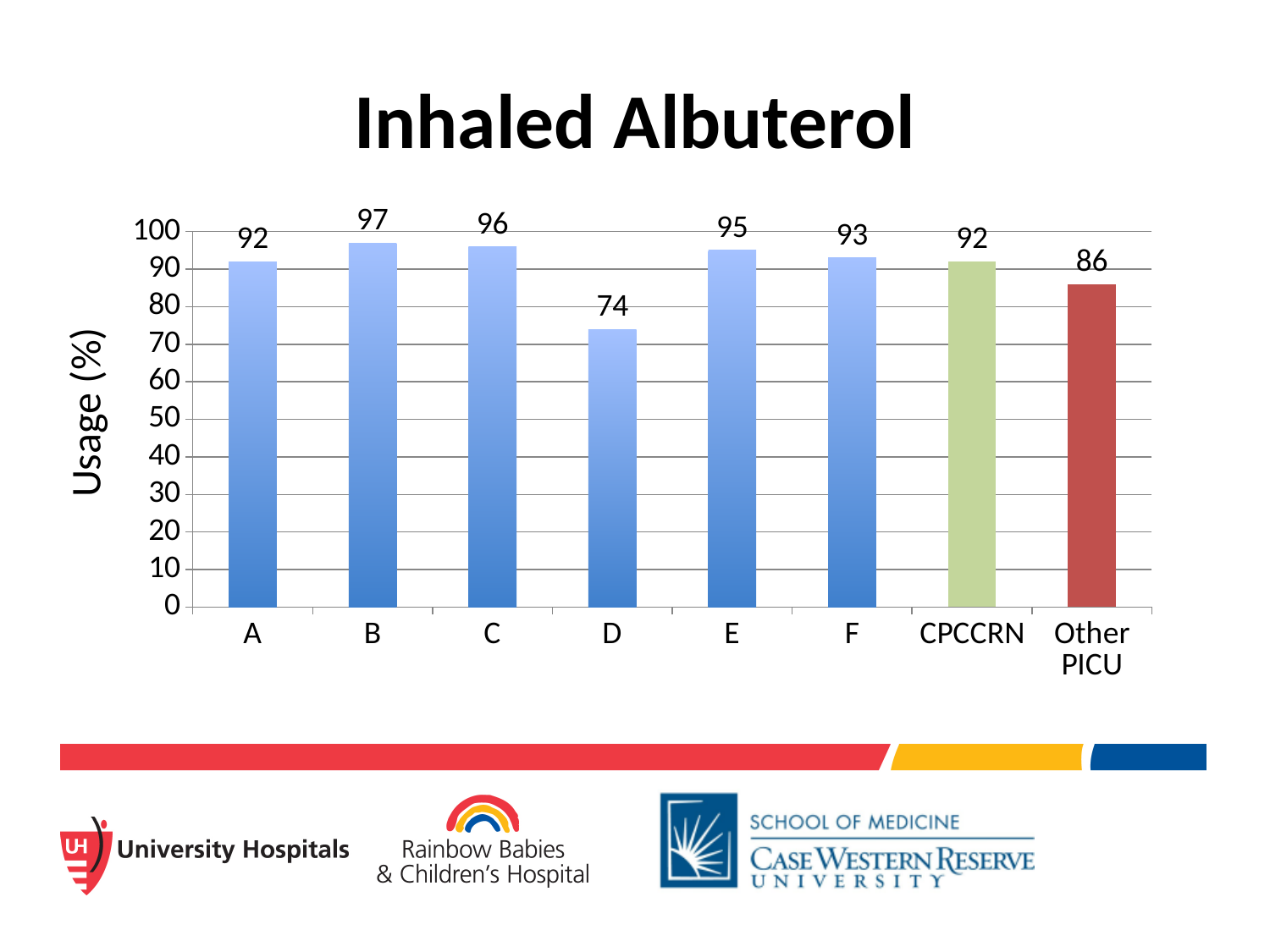
What is the usage value for CPCCRN? 92 Which category has the highest usage? B What is the title of the chart? Inhaled Albuterol What kind of chart is shown on the slide? bar chart Which category has the lowest usage? D What is the difference between the usage for B and the usage for D? 23 What is the usage value for Other PICU? 86 Which has a higher usage, site E or Other PICU? E How many categories are shown on the x axis? 8 What is the difference between the usage for CPCCRN and the usage for Other PICU? 6 Is the value for D greater or less than 80? less What is the usage value for site D? 74